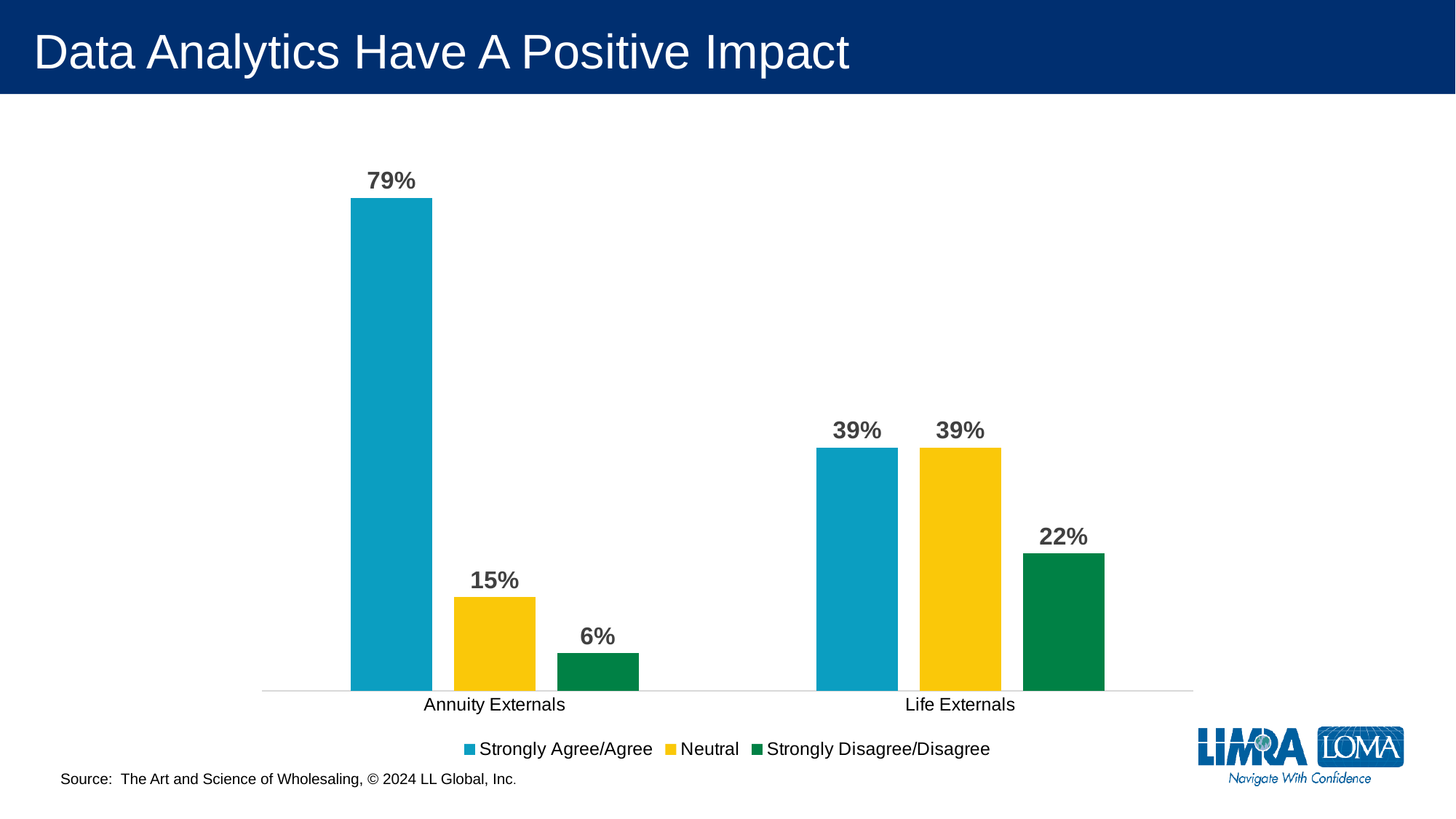
Which colour represents the Neutral series in the chart? Yellow Which group has the larger Neutral value, Annuity Externals or Life Externals? Life Externals How many categories are shown on the x axis? 2 What kind of chart is shown on the slide? Bar chart What is the Strongly Disagree/Disagree value for Annuity Externals? 6% What percentage of Annuity Externals Strongly Agree/Agree that data analytics have a positive impact? 79% What is the Neutral value for Life Externals? 39% How many series does the legend list? 3 What is the difference between the Strongly Agree/Agree values for Annuity Externals and Life Externals? 40 percentage points What is the Strongly Disagree/Disagree value for Life Externals? 22% Which bar in the chart has the highest value? Annuity Externals, Strongly Agree/Agree Which bar in the chart has the lowest value? Annuity Externals, Strongly Disagree/Disagree